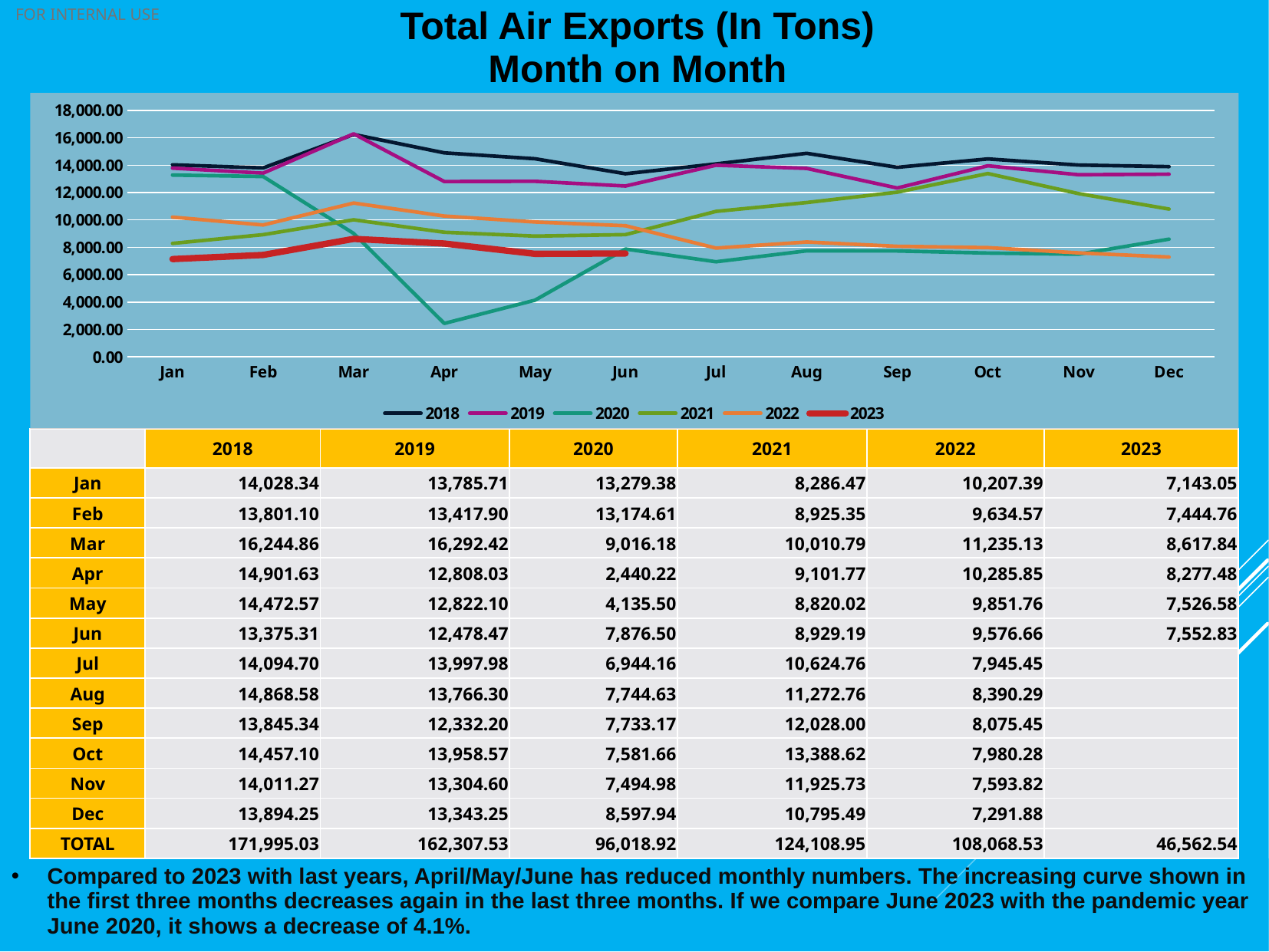
What is the difference between the March and January values for 2018? 2,216.52 How many series does the chart legend list? 6 Which is larger, the March value for 2019 or the March value for 2018? 2019 What is the value for April in the 2020 series? 2,440.22 Does the 2023 series rise or fall from March to June? fall What is the difference between the June 2020 value and the June 2023 value? 323.67 How many months are shown along the x axis of the chart? 12 In which month does the 2020 series reach its lowest value? Apr What colour is the 2023 line in the chart? red Is the January value for the 2021 series greater or less than 10,000.00? less What kind of chart is shown on the slide? line chart In which month does the 2018 series reach its highest value? Mar